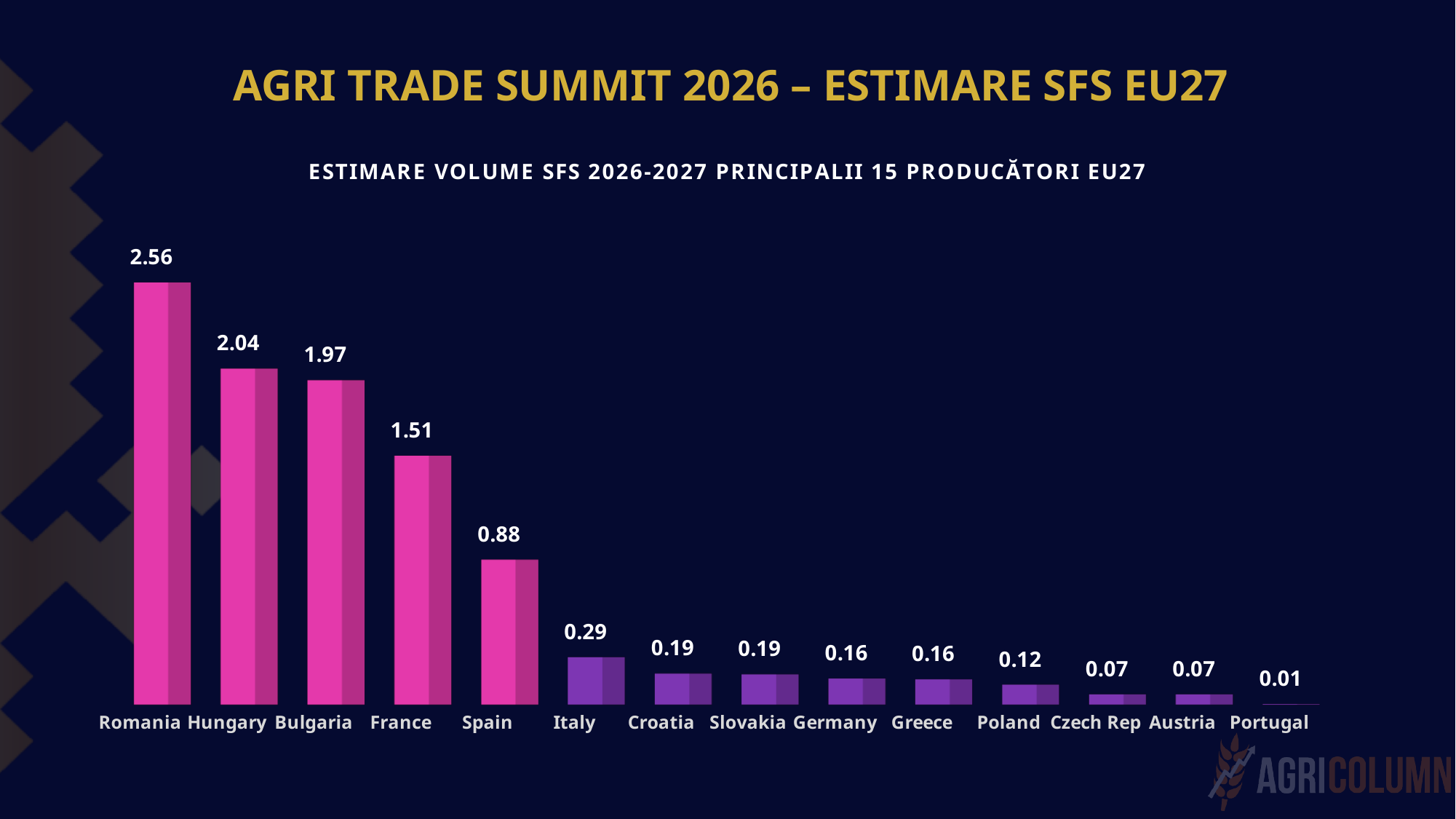
What kind of chart is shown on the slide? Bar chart How many countries are shown on the chart? 14 What is the value for France? 1.51 Which country has the highest value? Romania Do the values rise or fall from left to right along the x axis? Fall What is the value for Italy? 0.29 Which is larger, the value for Bulgaria or the value for France? Bulgaria Which country has the lowest value? Portugal What is the difference between the values for Spain and Italy? 0.59 What is the value for Romania? 2.56 What is the difference between the values for Romania and Hungary? 0.52 What is the value for Portugal? 0.01